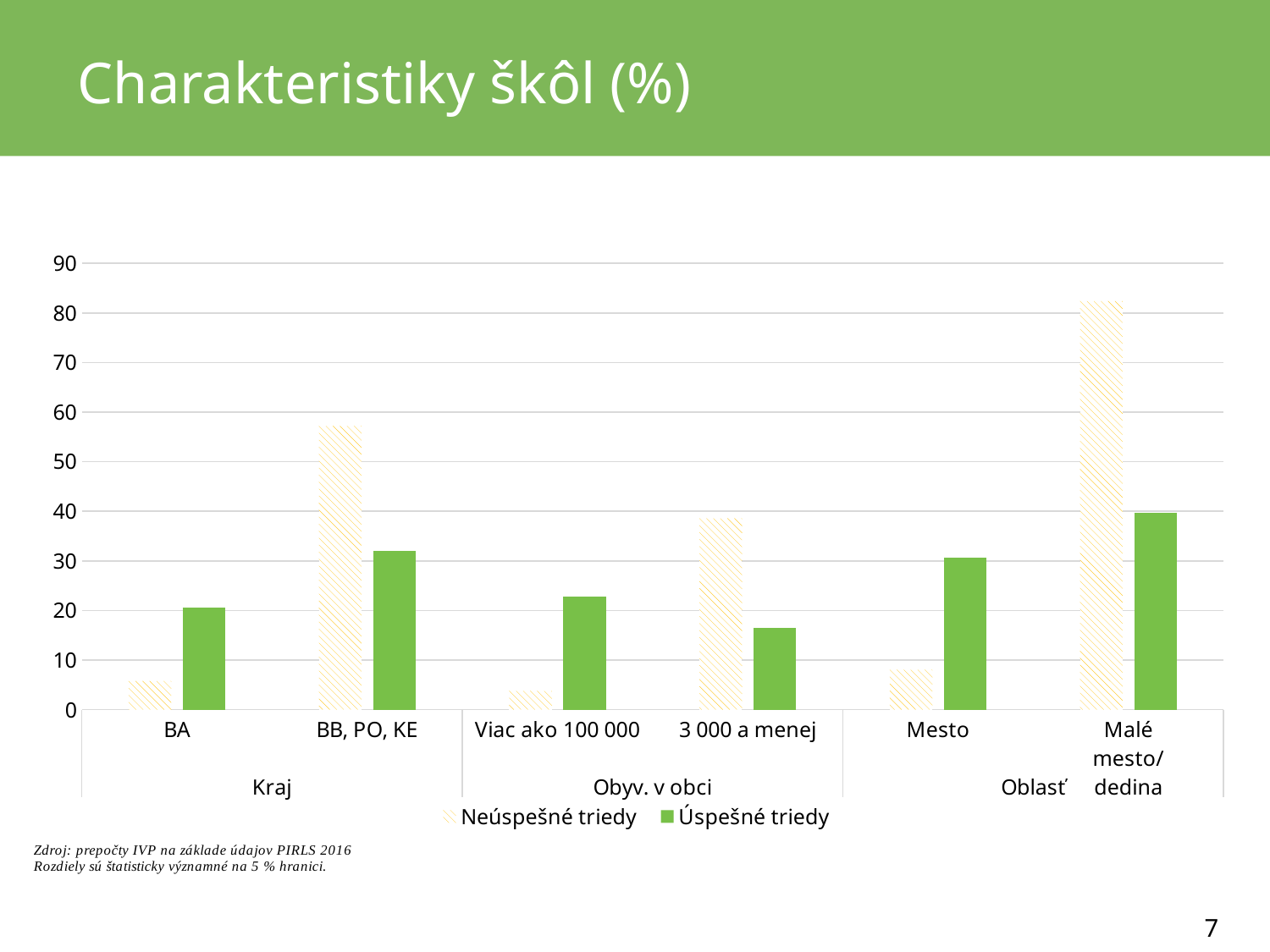
Which category has the highest value for Neúspešné triedy? Malé mesto/dedina Which category has the lowest value for Úspešné triedy? 3 000 a menej Which category has the highest value for Úspešné triedy? Malé mesto/dedina Is the Neúspešné triedy value for Malé mesto/dedina greater or less than 80? greater For BB, PO, KE, which series has the larger value, Neúspešné triedy or Úspešné triedy? Neúspešné triedy Is the Neúspešné triedy value for BA greater or less than 10? less How many series does the legend list? 2 For Mesto, which series has the larger value, Neúspešné triedy or Úspešné triedy? Úspešné triedy How many categories are shown on the x axis? 6 What kind of chart is shown on the slide? bar chart Is the Úspešné triedy value for Mesto greater or less than 20? greater